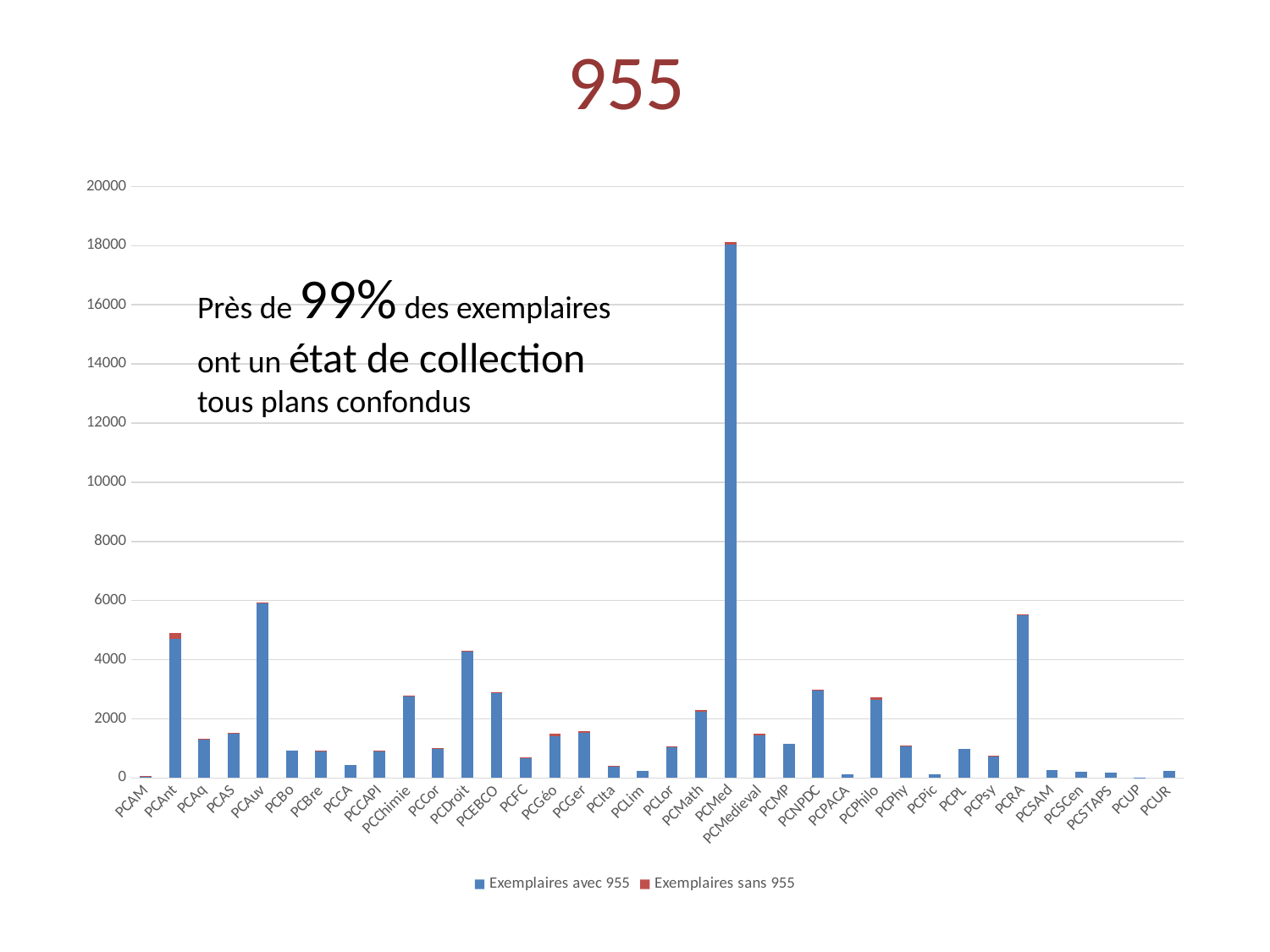
Which is larger, the bar for PCAuv or the bar for PCAnt? PCAuv Is the value for PCAuv greater or less than 4000? greater Is the value for PCNPDC greater or less than 2000? greater Which category has the highest total bar? PCMed What kind of chart is shown on the slide? bar chart Which is larger, the bar for PCRA or the bar for PCNPDC? PCRA What are the two legend entries of the chart? Exemplaires avec 955, Exemplaires sans 955 Is the value for PCMed greater or less than 16000? greater How many series does the legend list? 2 How many categories are shown on the x axis? 36